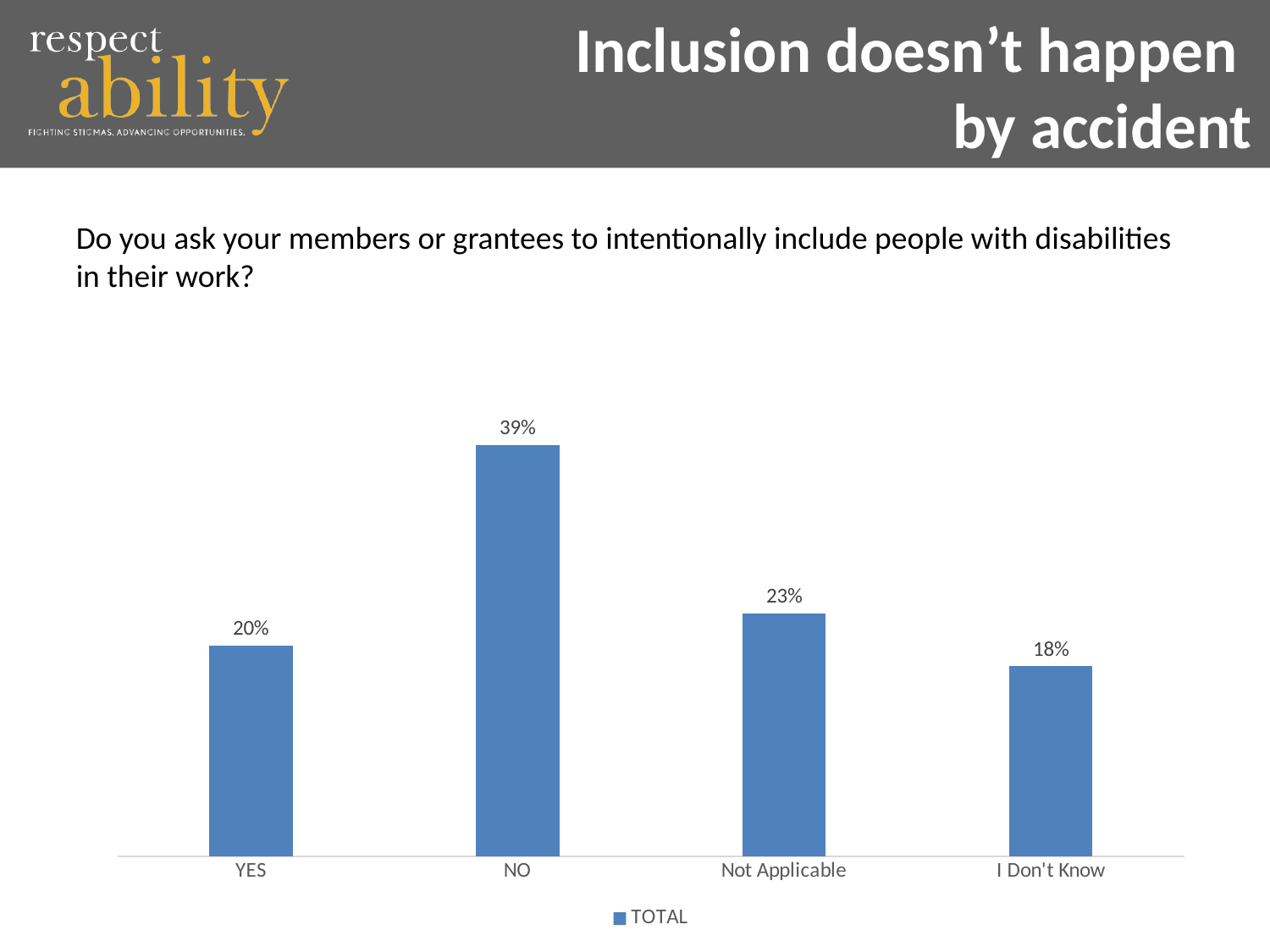
What percentage of respondents answered YES? 20% Which response category has the highest value? NO What is the value shown for I Don't Know? 18% What series name is listed in the chart legend? TOTAL What is the value shown for Not Applicable? 23% What type of chart is shown on the slide? Bar chart Which response category has the lowest value? I Don't Know Which is larger, the value for YES or the value for Not Applicable? Not Applicable What is the difference between the NO and YES percentages? 19% How many response categories are shown in the chart? 4 What percentage of respondents answered NO? 39% What is the difference between the Not Applicable and I Don't Know percentages? 5%